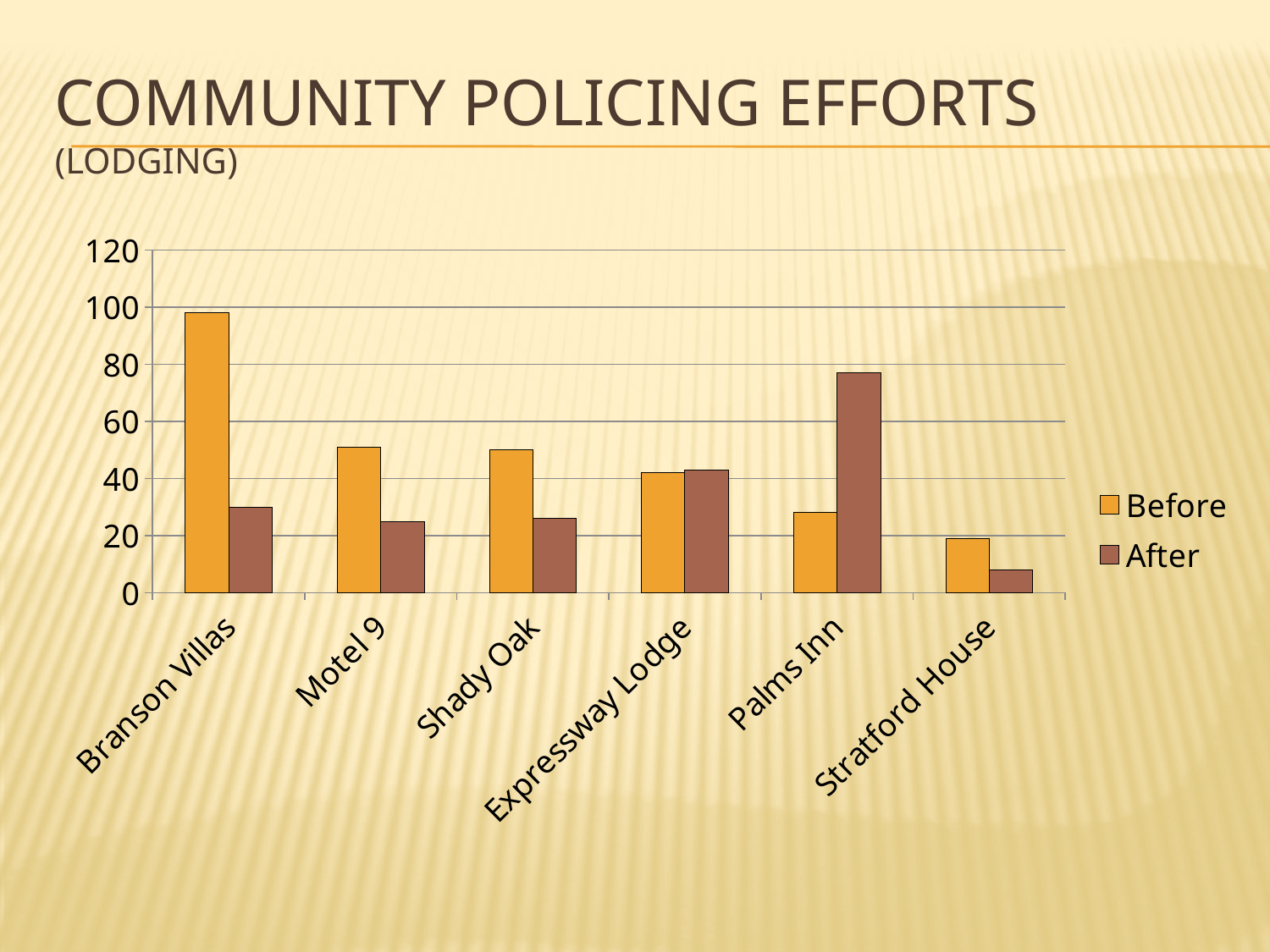
How many series does the legend list? 2 Which establishment has the lowest Before value? Stratford House For Branson Villas, which is larger, the Before value or the After value? Before For Palms Inn, which is larger, the Before value or the After value? After What kind of chart is shown on the slide? bar chart Is the Before value for Branson Villas greater or less than 80? greater Is the After value for Palms Inn greater or less than 60? greater How many lodging establishments are shown on the x axis? 6 Which establishment has the highest After value? Palms Inn Is the After value for Stratford House greater or less than 20? less Which establishment has the lowest After value? Stratford House Which establishment has the highest Before value? Branson Villas